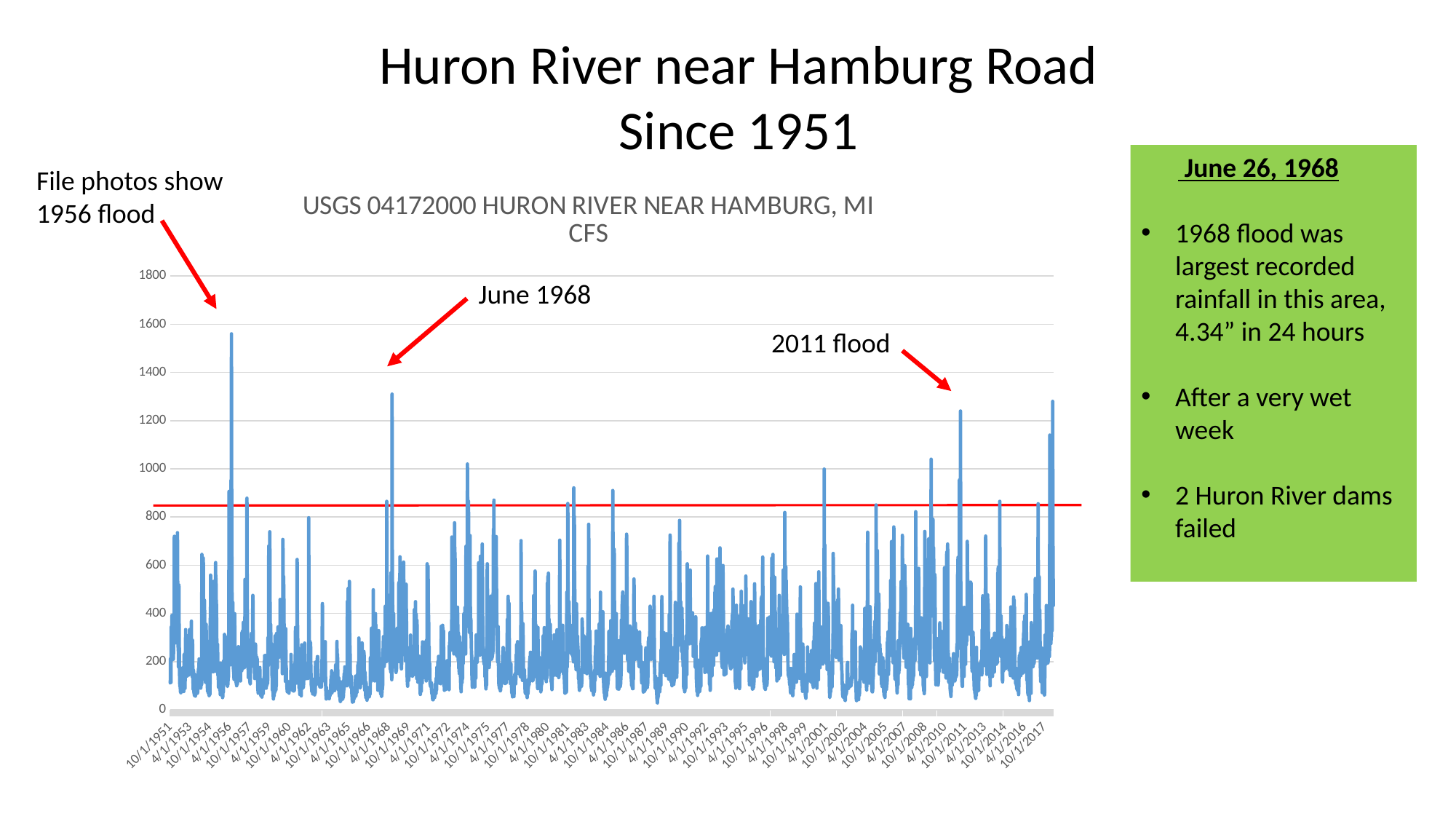
What is the title printed above the chart? USGS 04172000 HURON RIVER NEAR HAMBURG, MI CFS Which peak is larger on the chart, the 1956 flood or the June 1968 flood? 1956 flood Is the peak for the June 1968 flood greater or less than 1200? greater Is the peak for the 1956 flood greater or less than 1400? greater Of the three annotated floods (1956, June 1968, 2011), which has the highest peak on the chart? 1956 flood What is the first date label shown on the horizontal axis of the chart? 10/1/1951 Is the peak for the June 1968 flood greater or less than 1400? less Which peak is larger on the chart, the June 1968 flood or the 2011 flood? June 1968 Of the three annotated floods (1956, June 1968, 2011), which has the lowest peak on the chart? 2011 flood What kind of chart is shown on the slide? line chart What is the highest value labelled on the vertical axis of the chart? 1800